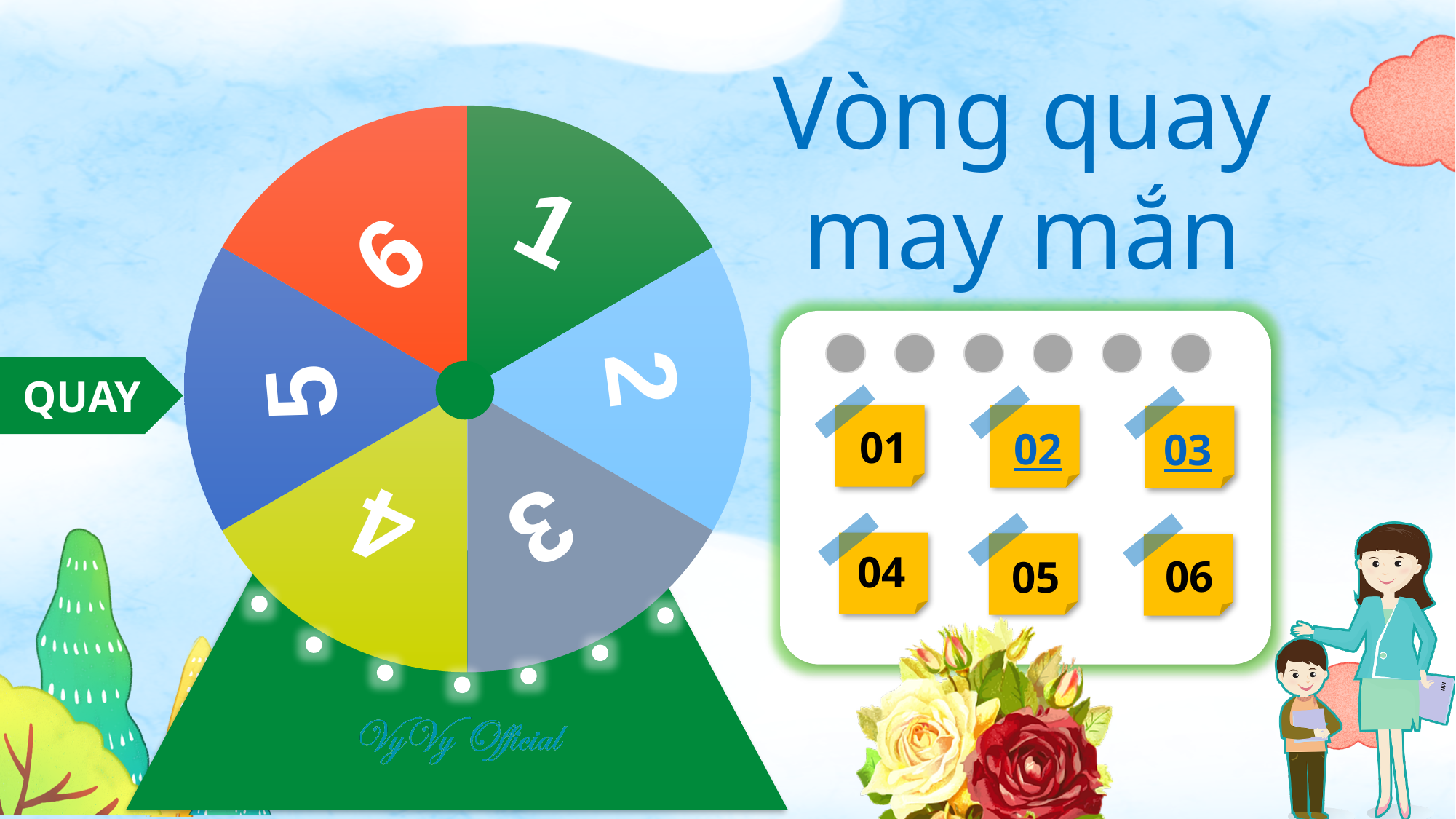
Which number is shown in the red segment of the wheel? 6 What is the title shown on the right of the slide? Vòng quay may mắn How many numbered segments does the wheel on the left have? 6 Which number is shown in the light blue segment of the wheel? 2 Which number is shown in the grey segment of the wheel? 3 What kind of chart-like shape is the wheel on the left of the slide? pie chart Which number is shown in the dark blue segment of the wheel? 5 What colour is the segment labelled 1 on the wheel? green Which number is shown in the yellow-green segment of the wheel? 4